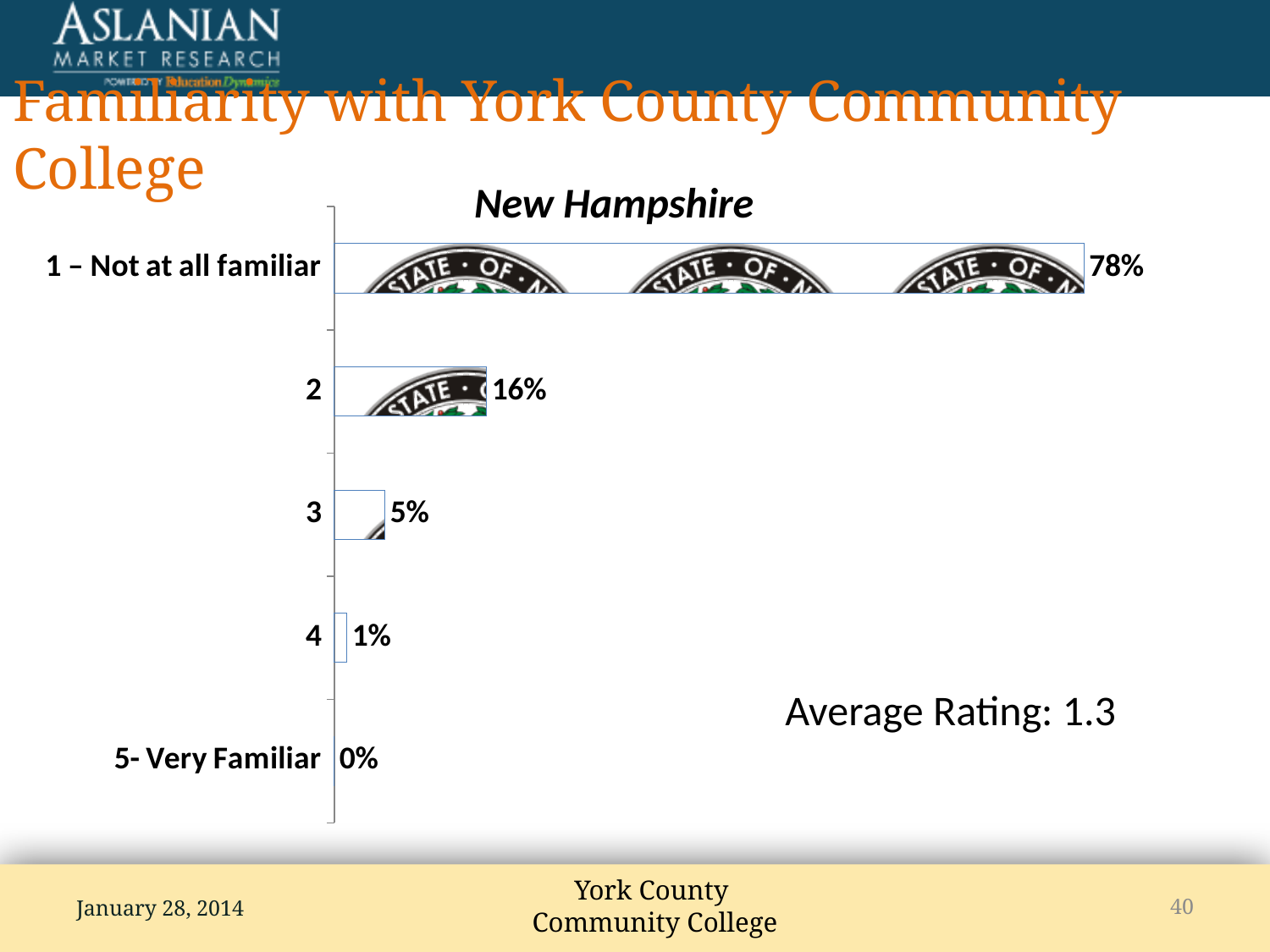
Which is larger, the value for category 2 or the value for category 3? Category 2 What is the chart's title? New Hampshire How many rating categories are shown in the chart? 5 What percentage of respondents rated their familiarity as '1 - Not at all familiar'? 78% What is the value for rating category 2? 16% Which rating category has the highest value? 1 - Not at all familiar What is the value for rating category 3? 5% What is the value for rating category 4? 1% Which rating category has the lowest value? 5- Very Familiar What kind of chart is shown on the slide? Bar chart What is the difference between the values for '1 - Not at all familiar' and category 2? 62 percentage points What is the value for '5- Very Familiar'? 0%